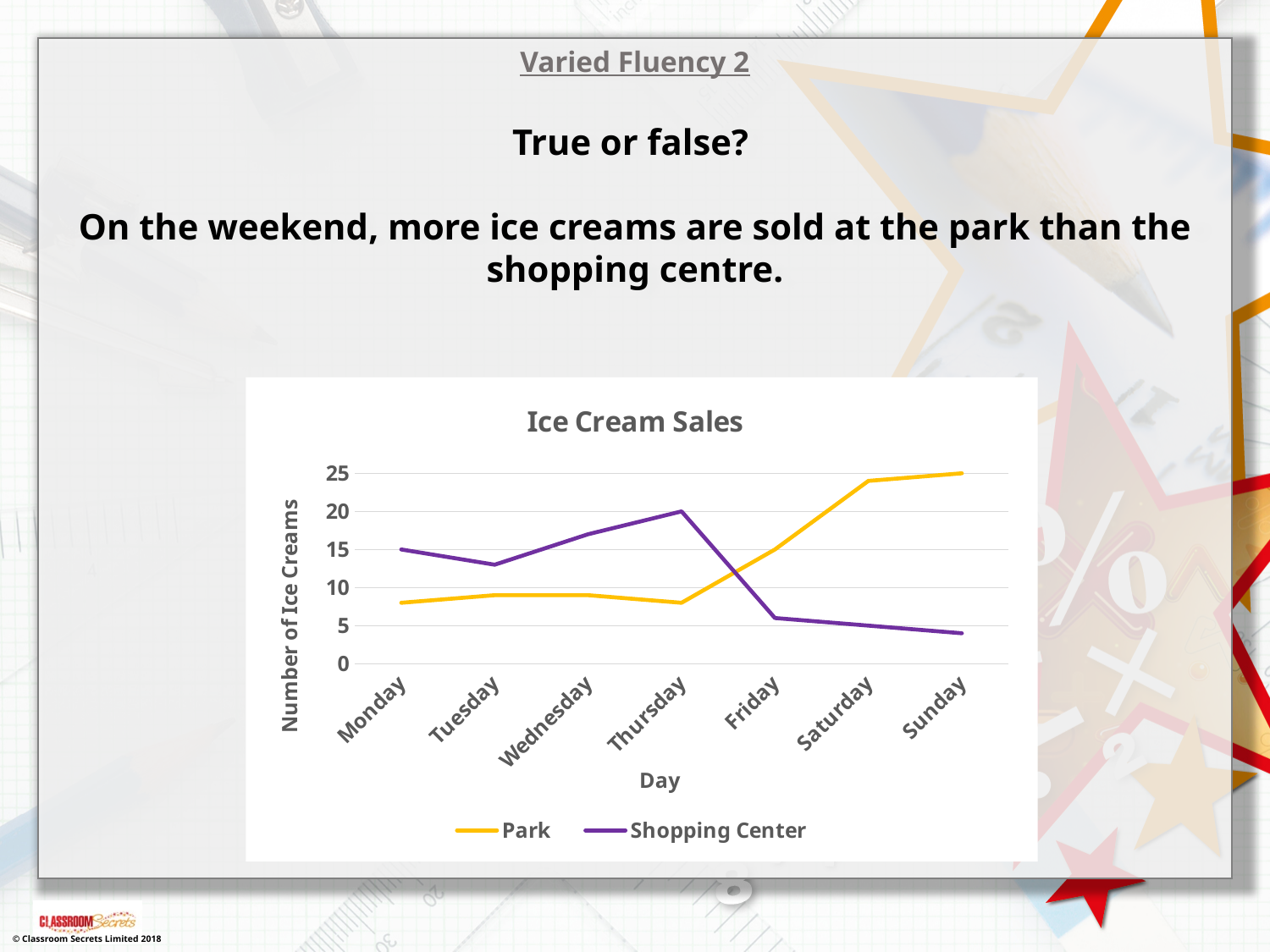
Is the value for the Park on Monday greater or less than 10? less How many ice creams were sold at the Park on Sunday? 25 What is the title of the chart? Ice Cream Sales How many days are shown on the x axis? 7 Do Shopping Center sales rise or fall from Thursday to Sunday? Fall How many ice creams were sold at the Shopping Center on Monday? 15 What kind of chart is shown on the slide? Line chart How many ice creams were sold at the Shopping Center on Thursday? 20 Is the value for the Shopping Center on Sunday greater or less than 5? less On which day were Shopping Center sales highest? Thursday How many series does the legend list? 2 On Saturday, which series has the higher value, Park or Shopping Center? Park